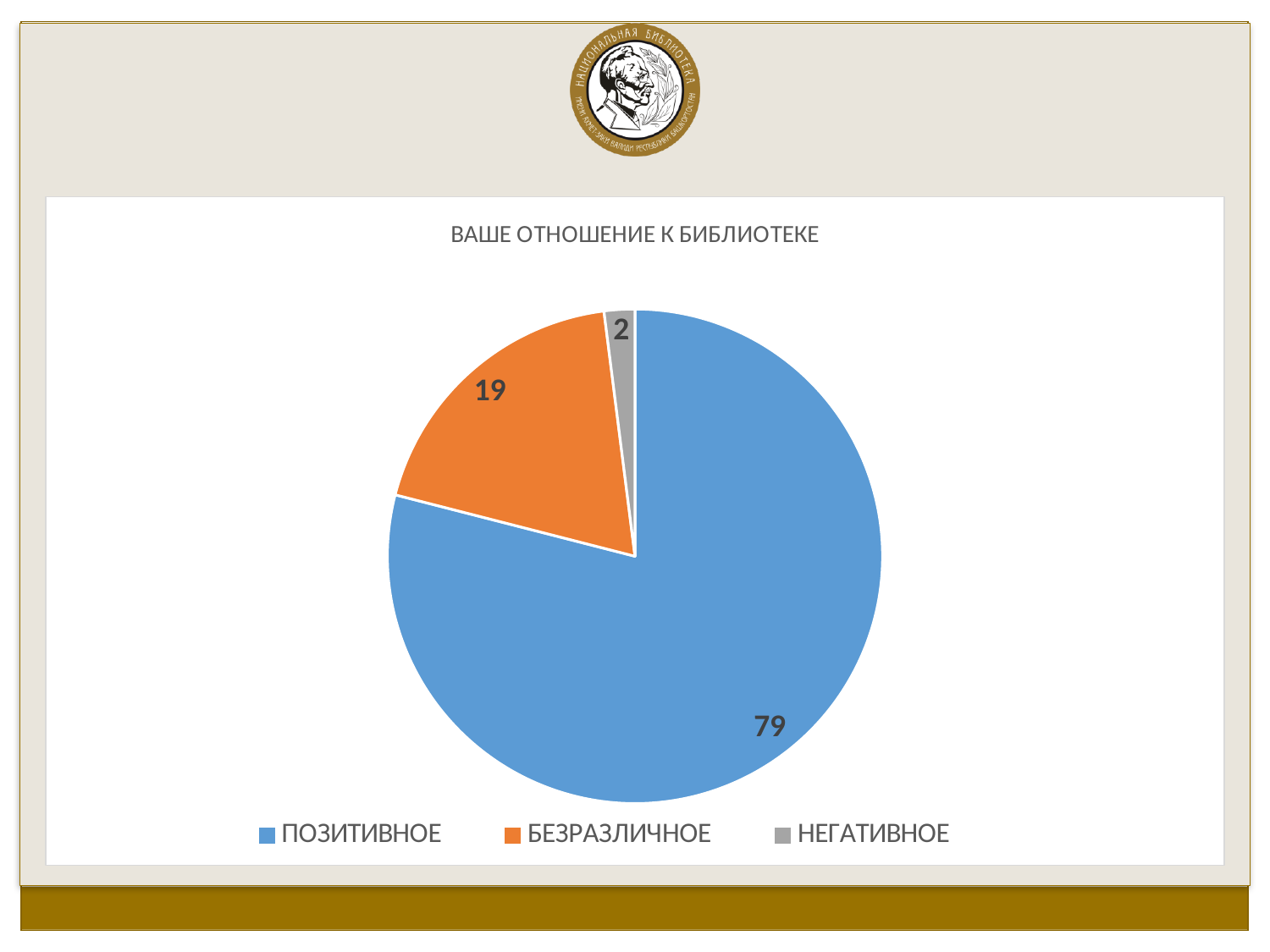
What is the title of the chart? ВАШЕ ОТНОШЕНИЕ К БИБЛИОТЕКЕ What kind of chart is shown on the slide? pie chart Which category has the largest slice? ПОЗИТИВНОЕ What is the value for НЕГАТИВНОЕ? 2 What is the value for ПОЗИТИВНОЕ? 79 What is the difference between the values for БЕЗРАЗЛИЧНОЕ and НЕГАТИВНОЕ? 17 What is the difference between the values for ПОЗИТИВНОЕ and БЕЗРАЗЛИЧНОЕ? 60 How many categories does the pie chart show? 3 What is the value for БЕЗРАЗЛИЧНОЕ? 19 Which category has the smallest slice? НЕГАТИВНОЕ What colour is the slice for БЕЗРАЗЛИЧНОЕ? orange Which is larger, the value for БЕЗРАЗЛИЧНОЕ or the value for НЕГАТИВНОЕ? БЕЗРАЗЛИЧНОЕ